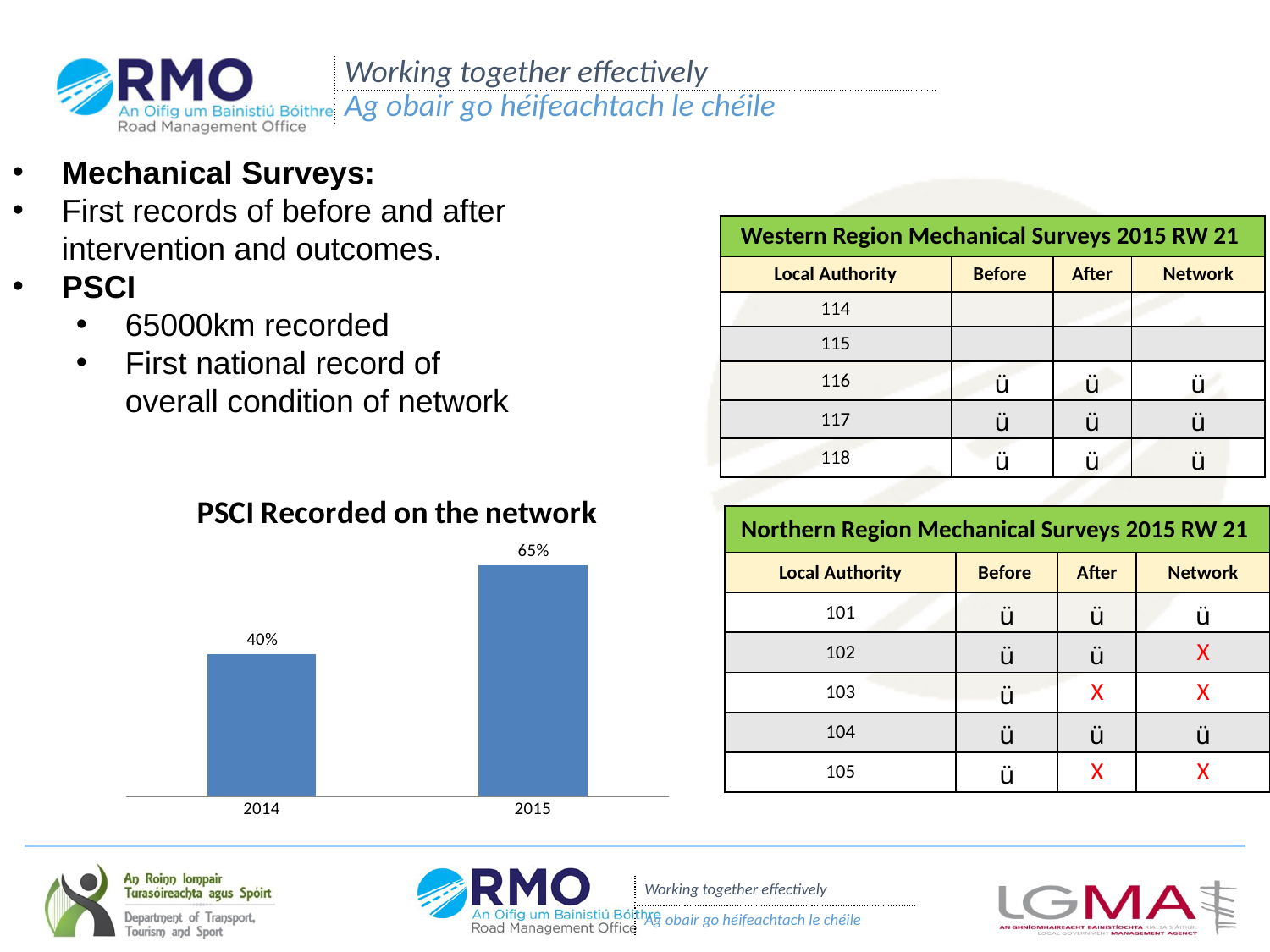
In the PSCI Recorded on the network chart, is the value for 2014 or 2015 larger? 2015 What is the title of the chart on the slide? PSCI Recorded on the network Which year has the highest value in the PSCI Recorded on the network chart? 2015 What is the value for 2015 in the PSCI Recorded on the network chart? 65% Which year has the lowest value in the PSCI Recorded on the network chart? 2014 How many years are shown on the x axis of the PSCI Recorded on the network chart? 2 Do the values in the PSCI Recorded on the network chart rise or fall from 2014 to 2015? Rise What colour are the bars in the PSCI Recorded on the network chart? Blue What kind of chart is the PSCI Recorded on the network chart? Bar chart What is the value for 2014 in the PSCI Recorded on the network chart? 40% What is the difference between the 2015 and 2014 values in the PSCI Recorded on the network chart? 25%